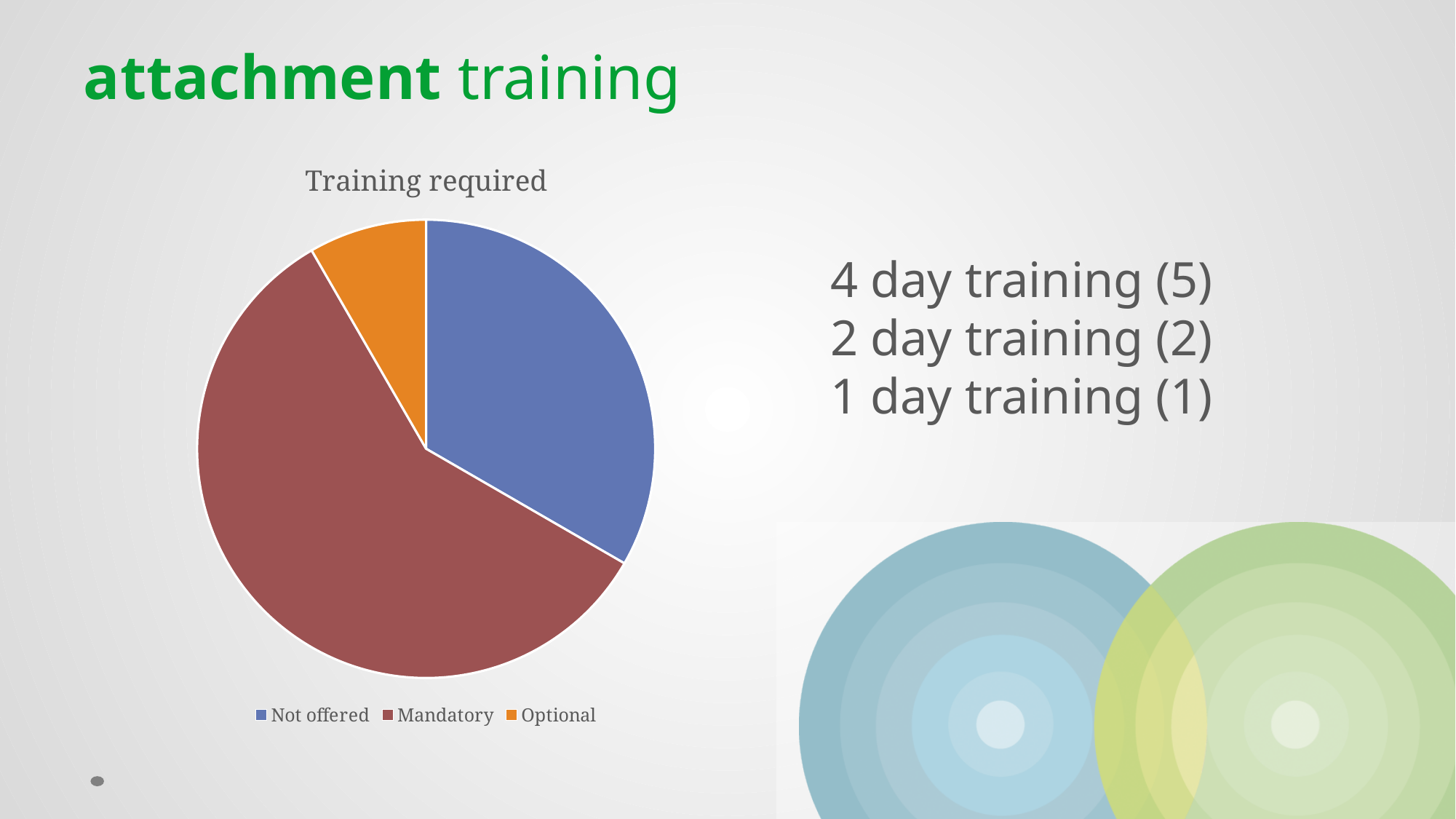
Which category has the largest slice of the pie? Mandatory How many slices does the pie chart have? 3 Which category has the smallest slice of the pie? Optional Which slice is larger, Not offered or Mandatory? Mandatory Does the Mandatory slice take up more or less than half of the pie? More Which slice is larger, Not offered or Optional? Not offered What colour is the Mandatory slice? Red How many entries does the legend list? 3 What kind of chart is shown on the slide? Pie chart What is the title of the chart? Training required